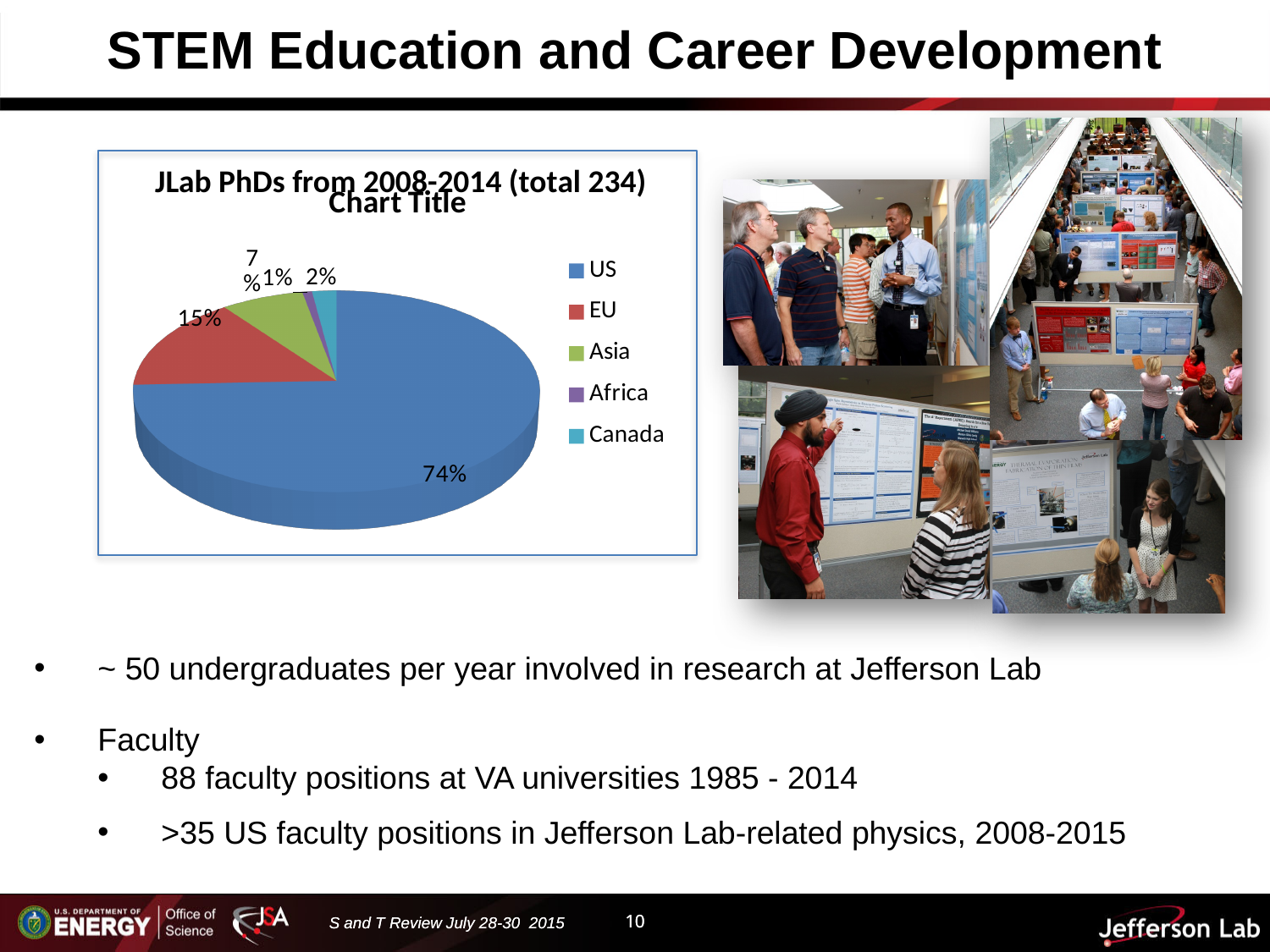
What share of JLab PhDs from 2008-2014 is from Asia? 7% Which region has the smallest share of JLab PhDs from 2008-2014? Africa How many categories does the legend of the pie chart list? 5 Which has a larger share of JLab PhDs, EU or Asia? EU What is the title of the pie chart? JLab PhDs from 2008-2014 (total 234) What is the difference in percentage points between the US share and the EU share of JLab PhDs? 59 percentage points What share of JLab PhDs from 2008-2014 is from Africa? 1% What kind of chart is shown on the slide? Pie chart What share of JLab PhDs from 2008-2014 is from the US? 74% Which region has the largest share of JLab PhDs from 2008-2014? US